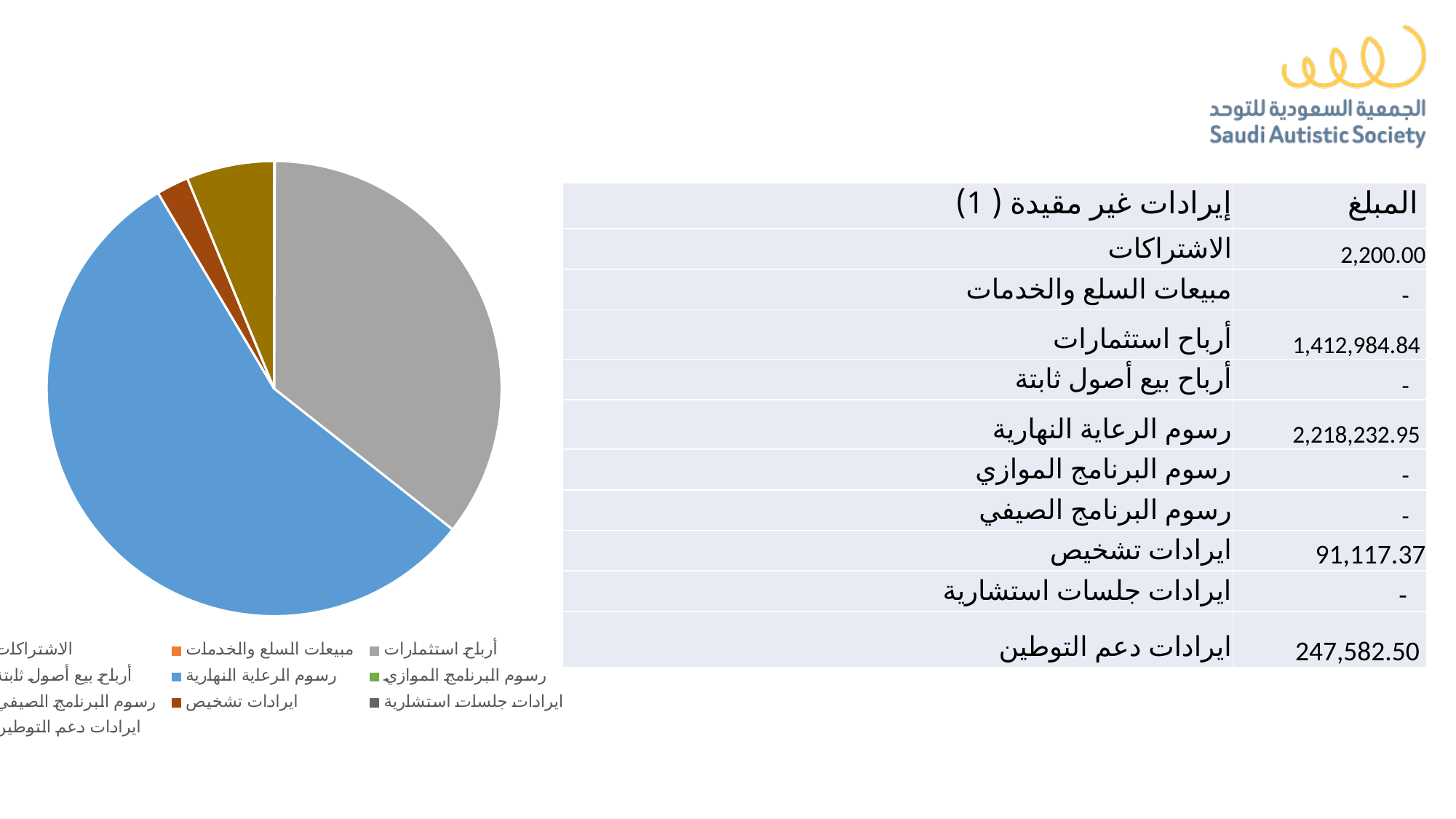
Which is larger in the pie chart, رسوم الرعاية النهارية or أرباح استثمارات? رسوم الرعاية النهارية How many categories does the pie chart's legend list? 10 What colour is the slice for رسوم الرعاية النهارية in the pie chart? blue Which is larger in the pie chart, أرباح استثمارات or ايرادات دعم التوطين? أرباح استثمارات According to the table next to the pie chart, what is the value for رسوم الرعاية النهارية? 2,218,232.95 Which is larger in the pie chart, ايرادات تشخيص or ايرادات دعم التوطين? ايرادات دعم التوطين Which category has the largest slice in the pie chart? رسوم الرعاية النهارية Using the table values, what is the difference between رسوم الرعاية النهارية and أرباح استثمارات? 805,248.11 How many slices are visible in the pie chart? 4 According to the table next to the pie chart, what is the value for أرباح استثمارات? 1,412,984.84 What kind of chart is shown on the slide? pie chart According to the table next to the pie chart, what is the value for ايرادات تشخيص? 91,117.37